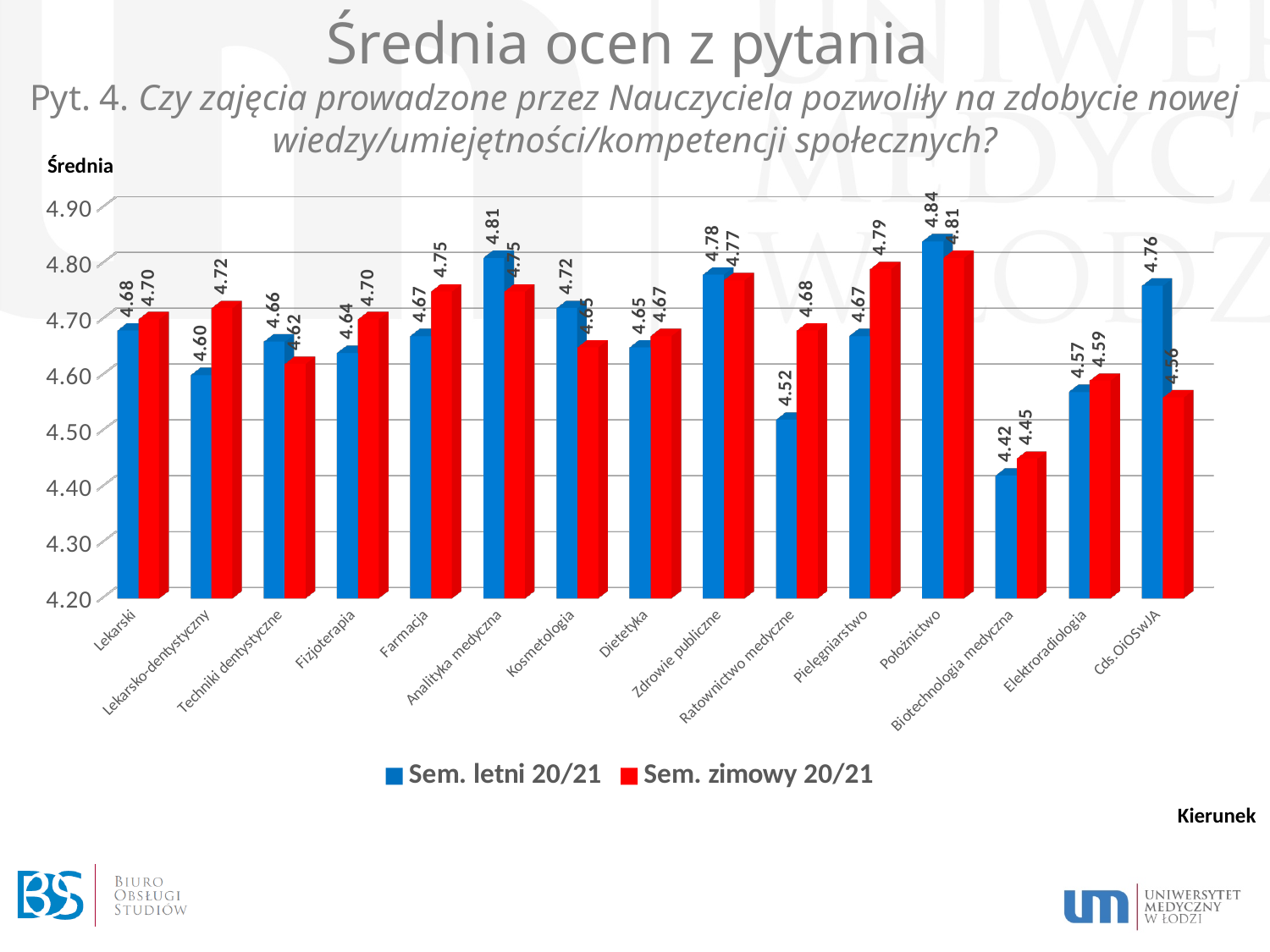
Which colour represents Sem. zimowy 20/21 in the legend? red What is the value for Lekarski in Sem. letni 20/21? 4.68 What is the difference between the Sem. zimowy 20/21 and Sem. letni 20/21 values for Lekarsko-dentystyczny? 0.12 Which category has the lowest value in Sem. zimowy 20/21? Biotechnologia medyczna Which is larger for Farmacja: the Sem. letni 20/21 value or the Sem. zimowy 20/21 value? Sem. zimowy 20/21 How many categories (kierunki) are shown on the x axis? 15 Is the Sem. letni 20/21 value for Biotechnologia medyczna greater or less than 4.50? less What type of chart is shown on the slide? bar chart What is the value for Pielęgniarstwo in Sem. zimowy 20/21? 4.79 How many series does the legend list? 2 What is the value for Ratownictwo medyczne in Sem. letni 20/21? 4.52 Which category has the highest value in Sem. letni 20/21? Położnictwo